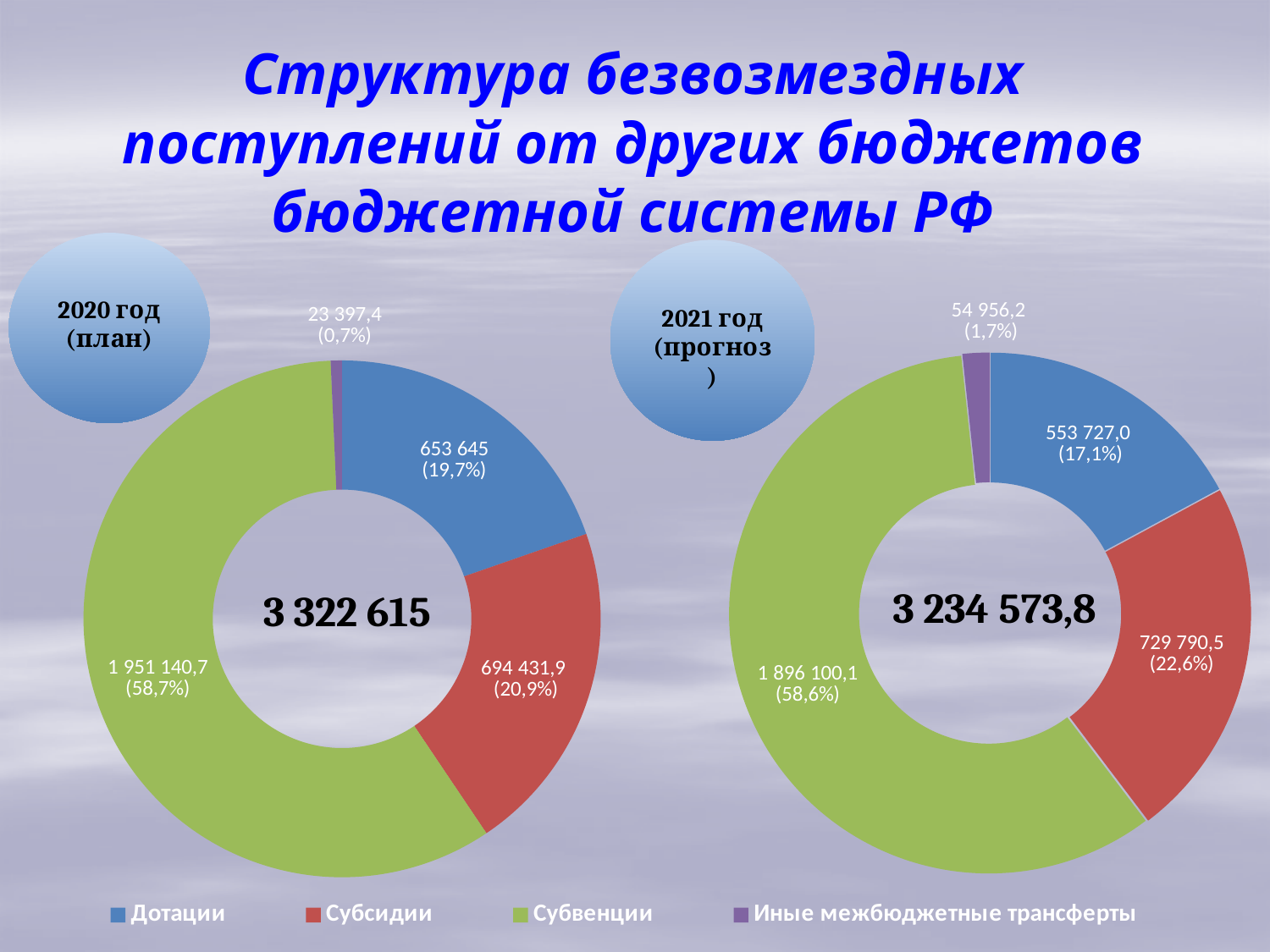
In the 2020 год (план) chart, which category has the smallest value? Иные межбюджетные трансферты What is the difference between the Субсидии value in the 2021 год (прогноз) chart and the Субсидии value in the 2020 год (план) chart? 35 358,6 In the 2020 год (план) chart, what share of the total do Дотации make up? 19,7% How many categories does the legend list? 4 Which colour represents Субвенции in the legend? Green In the 2021 год (прогноз) chart, what share of the total do Иные межбюджетные трансферты make up? 1,7% In the 2021 год (прогноз) chart, what value is shown for Субсидии? 729 790,5 What total is shown in the centre of the 2021 год (прогноз) chart? 3 234 573,8 What kind of chart is used on this slide? Doughnut (pie) chart In the 2020 год (план) chart, which is larger: Дотации or Субсидии? Субсидии In the 2021 год (прогноз) chart, which category has the largest value? Субвенции In the 2020 год (план) chart, what value is shown for Субвенции? 1 951 140,7